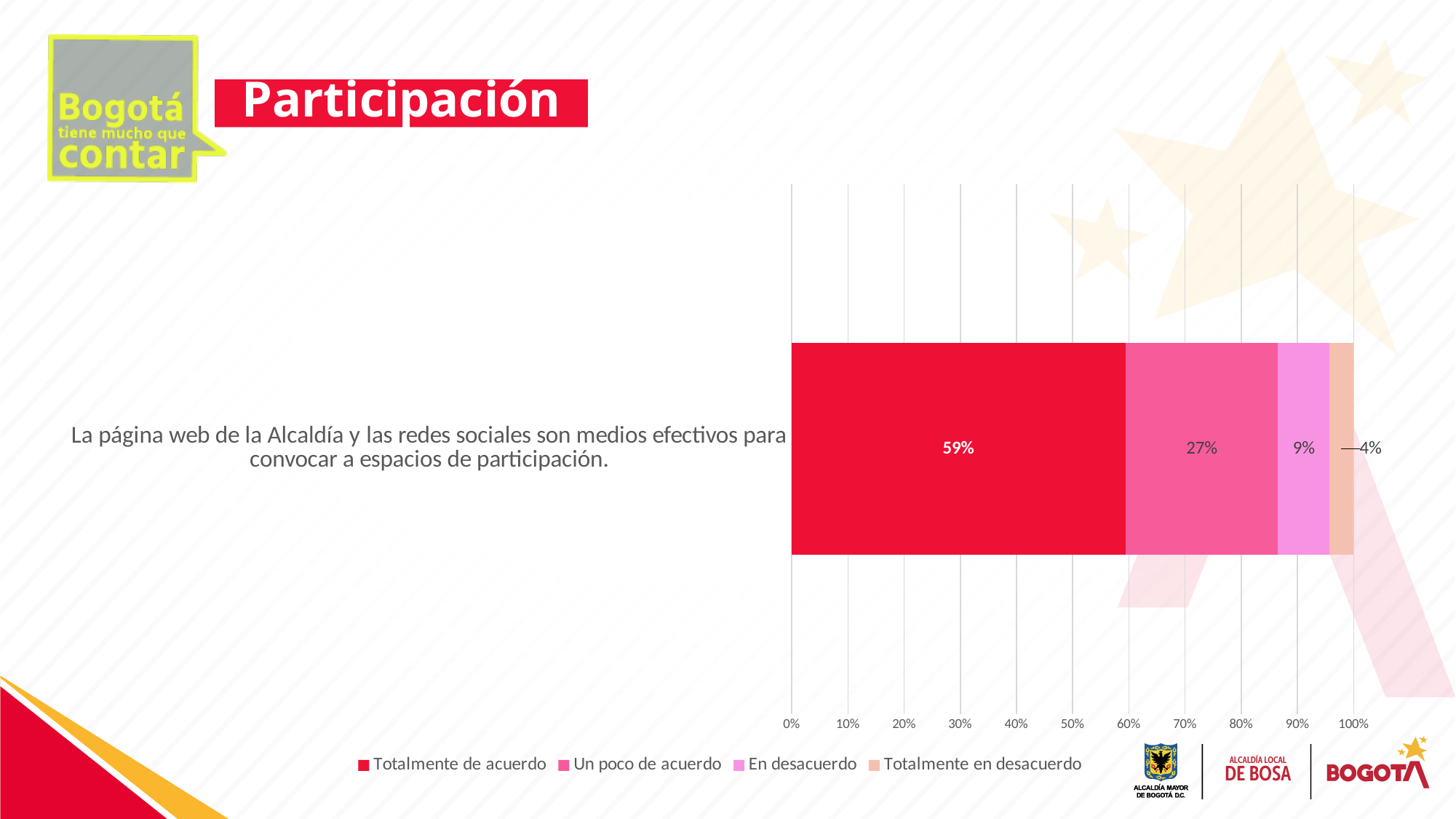
Which response category has the smallest share? Totalmente en desacuerdo How many series does the legend list? 4 What percentage of respondents answered "Totalmente de acuerdo"? 59% What percentage of respondents answered "En desacuerdo"? 9% What is the difference in percentage points between "Totalmente de acuerdo" and "Un poco de acuerdo"? 32 What kind of chart is shown on the slide? Stacked bar chart What is the combined share of "Totalmente de acuerdo" and "Un poco de acuerdo"? 86% Is the value for "Totalmente de acuerdo" greater or less than 50%? greater Which is larger, the share for "En desacuerdo" or for "Totalmente en desacuerdo"? En desacuerdo Which response category has the largest share? Totalmente de acuerdo What percentage of respondents answered "Totalmente en desacuerdo"? 4% What percentage of respondents answered "Un poco de acuerdo"? 27%